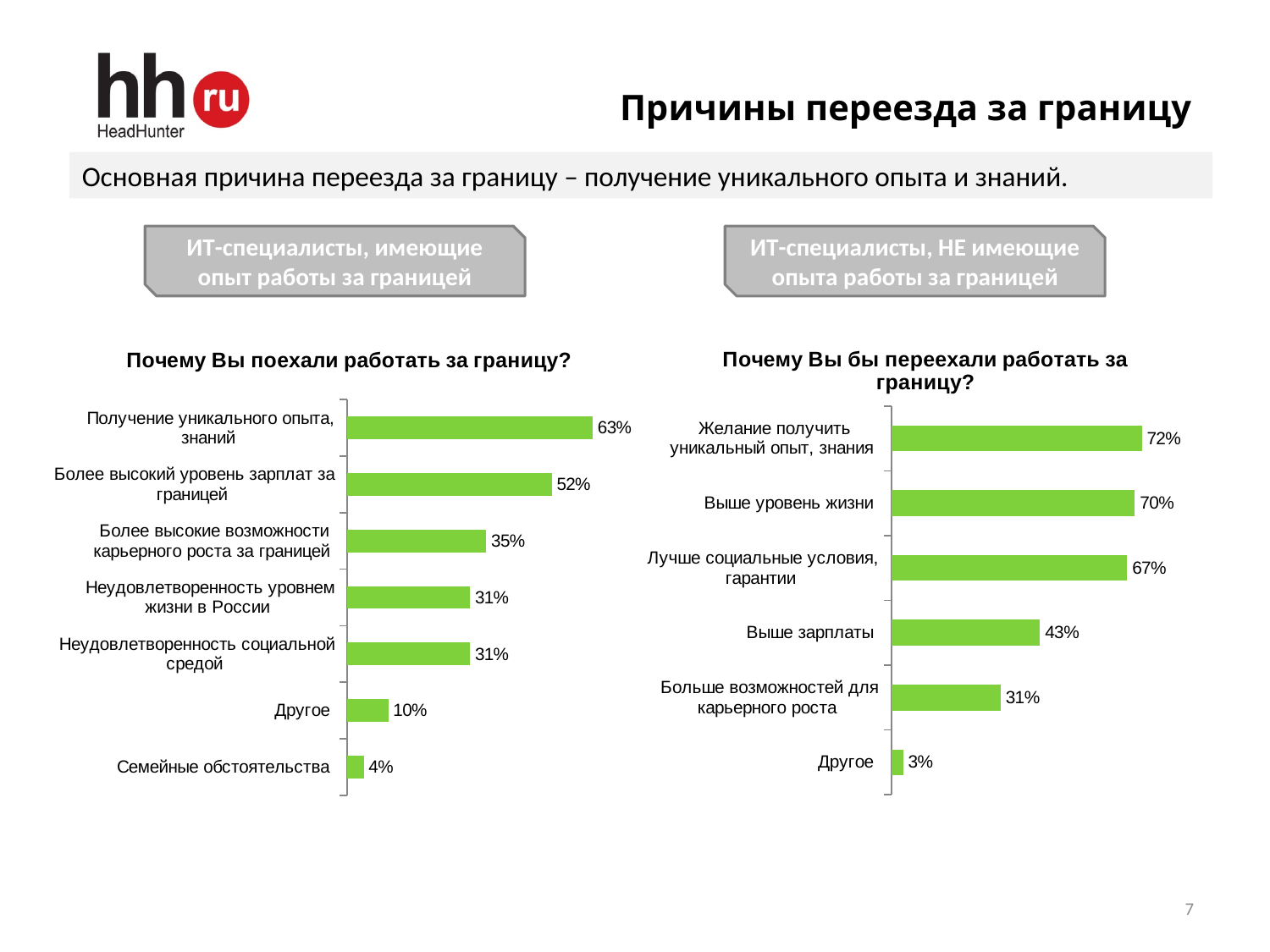
In the right chart 'Почему Вы бы переехали работать за границу?', what is the difference between 'Выше уровень жизни' and 'Больше возможностей для карьерного роста'? 39% What type of chart is the left chart 'Почему Вы поехали работать за границу?'? Bar chart In the left chart 'Почему Вы поехали работать за границу?', which category has the lowest value? Семейные обстоятельства In the left chart 'Почему Вы поехали работать за границу?', how many categories are shown? 7 In the left chart 'Почему Вы поехали работать за границу?', what is the difference between 'Получение уникального опыта, знаний' and 'Более высокие возможности карьерного роста за границей'? 28% Which is larger: 'Другое' in the left chart or 'Другое' in the right chart? Другое in the left chart (10%) In the right chart 'Почему Вы бы переехали работать за границу?', which category has the lowest value? Другое In the right chart 'Почему Вы бы переехали работать за границу?', which category has the highest value? Желание получить уникальный опыт, знания In the right chart 'Почему Вы бы переехали работать за границу?', what is the value for 'Выше зарплаты'? 43% In the right chart 'Почему Вы бы переехали работать за границу?', how many categories are shown? 6 In the left chart 'Почему Вы поехали работать за границу?', which category has the highest value? Получение уникального опыта, знаний In the left chart 'Почему Вы поехали работать за границу?', what is the value for 'Более высокий уровень зарплат за границей'? 52%